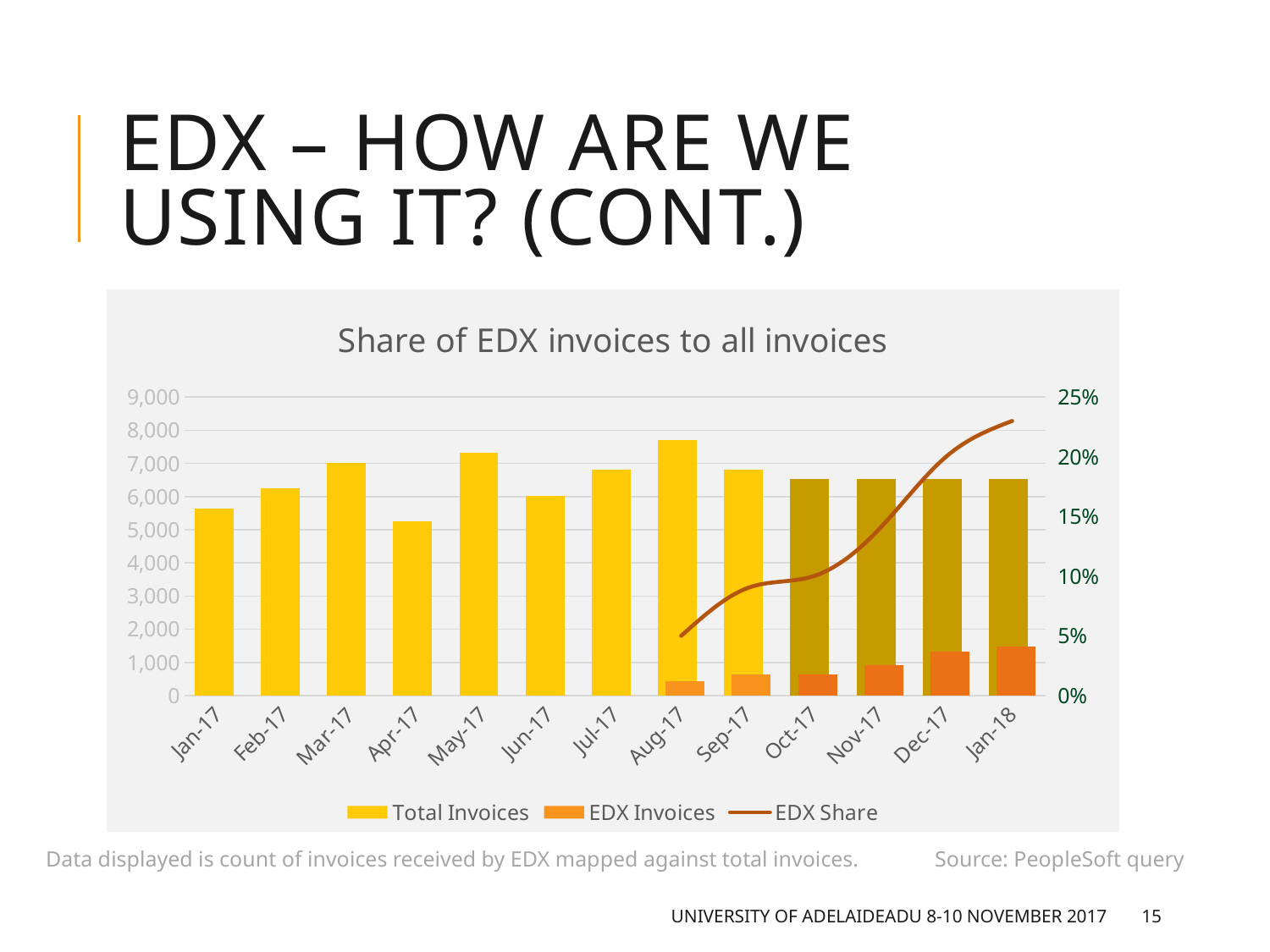
How many months are shown on the x axis of the chart? 13 Is the Total Invoices value for Aug-17 greater or less than 7,000? greater Is the Total Invoices value for Jan-17 greater or less than 6,000? less Does the EDX Share line rise or fall from Aug-17 to Jan-18? rise Is the EDX Share value for Jan-18 greater or less than 20%? greater What kind of chart is shown on the slide? A combination bar and line chart Which month has the highest EDX Invoices bar? Jan-18 Which month has the highest Total Invoices bar? Aug-17 How many series does the chart legend list? 3 Which month has the lowest Total Invoices bar? Apr-17 What is the title of the chart? Share of EDX invoices to all invoices Which is larger, the Total Invoices value for May-17 or for Jun-17? May-17